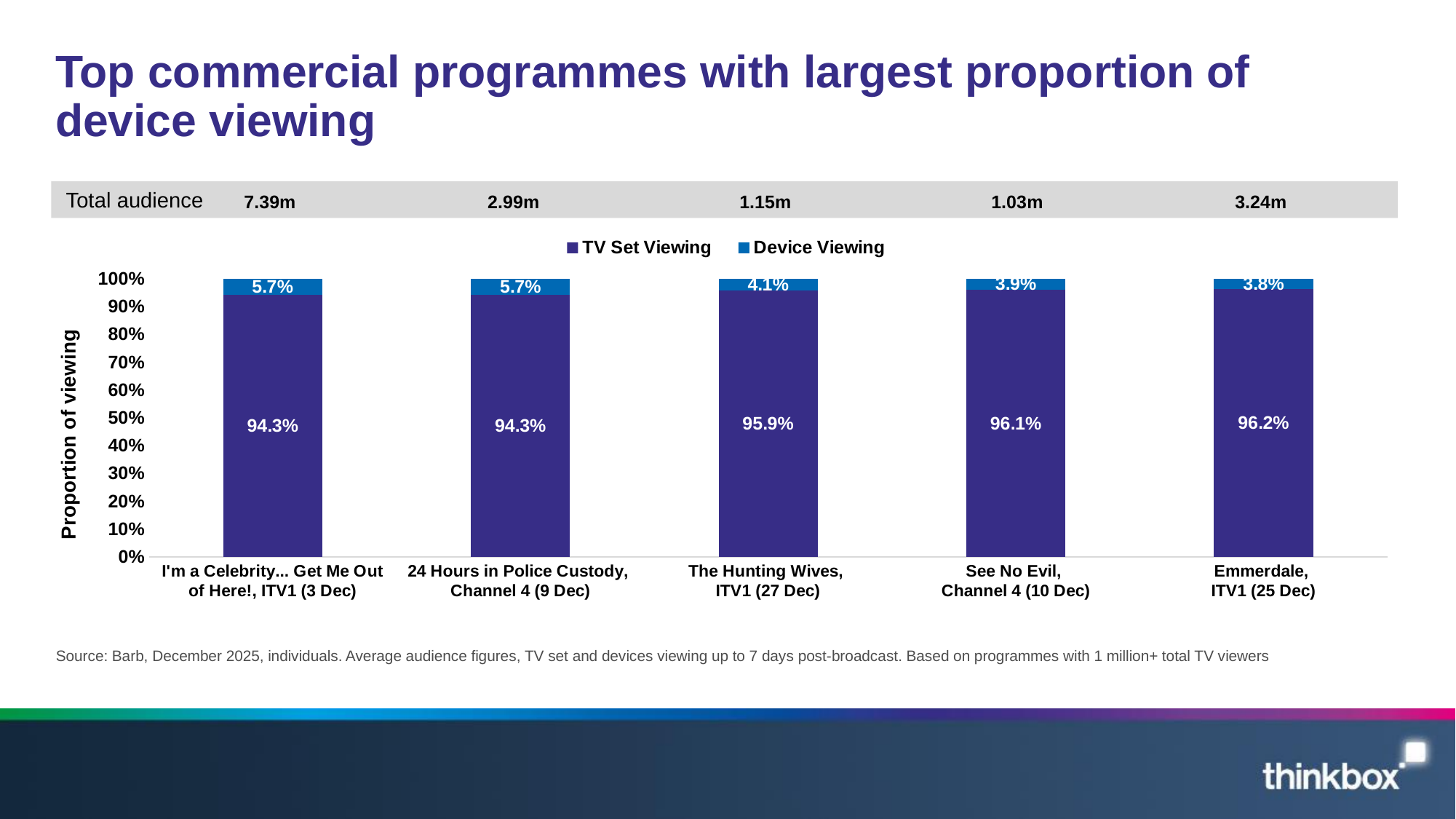
What is the TV Set Viewing value for Emmerdale, ITV1 (25 Dec)? 96.2% What is the TV Set Viewing value for 24 Hours in Police Custody, Channel 4 (9 Dec)? 94.3% What is the Device Viewing value for The Hunting Wives, ITV1 (27 Dec)? 4.1% What is the Device Viewing value for See No Evil, Channel 4 (10 Dec)? 3.9% How many programmes are shown on the x axis of the chart? 5 How many series does the chart legend list? 2 Which programme has the highest TV Set Viewing proportion? Emmerdale, ITV1 (25 Dec) Which programme has the lowest Device Viewing proportion? Emmerdale, ITV1 (25 Dec) Which is larger: the TV Set Viewing value for The Hunting Wives, ITV1 (27 Dec) or for See No Evil, Channel 4 (10 Dec)? See No Evil, Channel 4 (10 Dec) What is the total audience shown for I'm a Celebrity... Get Me Out of Here!, ITV1 (3 Dec)? 7.39m What is the difference between the Device Viewing value for I'm a Celebrity... Get Me Out of Here!, ITV1 (3 Dec) and for Emmerdale, ITV1 (25 Dec)? 1.9% What kind of chart is shown on the slide? Stacked bar chart